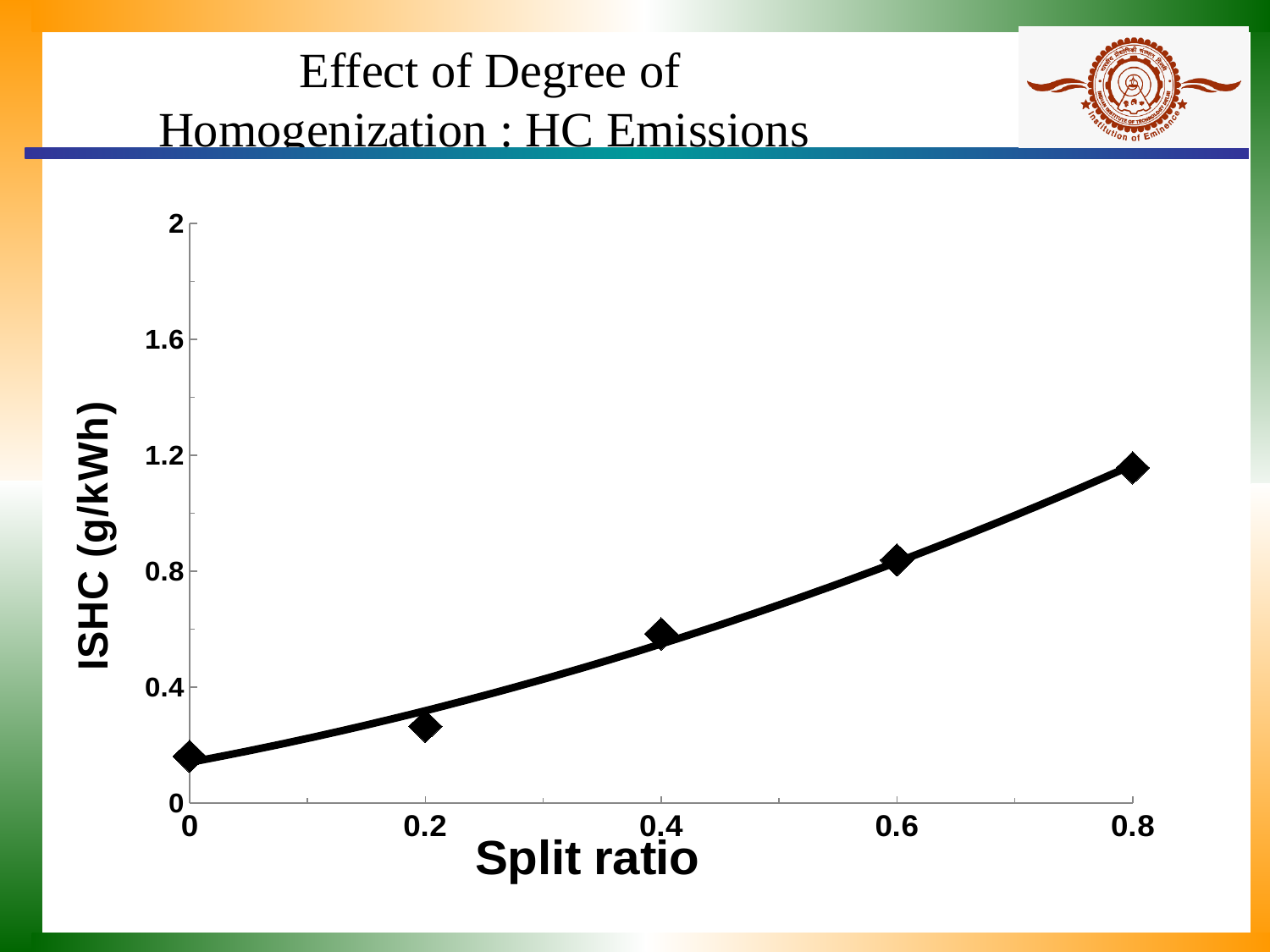
Is the ISHC value at a split ratio of 0.8 greater or less than 0.8 g/kWh? greater How many data points are plotted on the chart? 5 Is the ISHC value at a split ratio of 0.4 greater or less than 0.4 g/kWh? greater What is the label of the x axis? Split ratio Which has the higher ISHC value: a split ratio of 0.6 or a split ratio of 0.2? 0.6 At which split ratio is ISHC highest? 0.8 What kind of chart is shown on the slide? scatter chart with a trend line At which split ratio is ISHC lowest? 0 What is the label of the y axis? ISHC (g/kWh) Do the ISHC values rise or fall as the split ratio increases? rise Is the ISHC value at a split ratio of 0.2 greater or less than 0.4 g/kWh? less